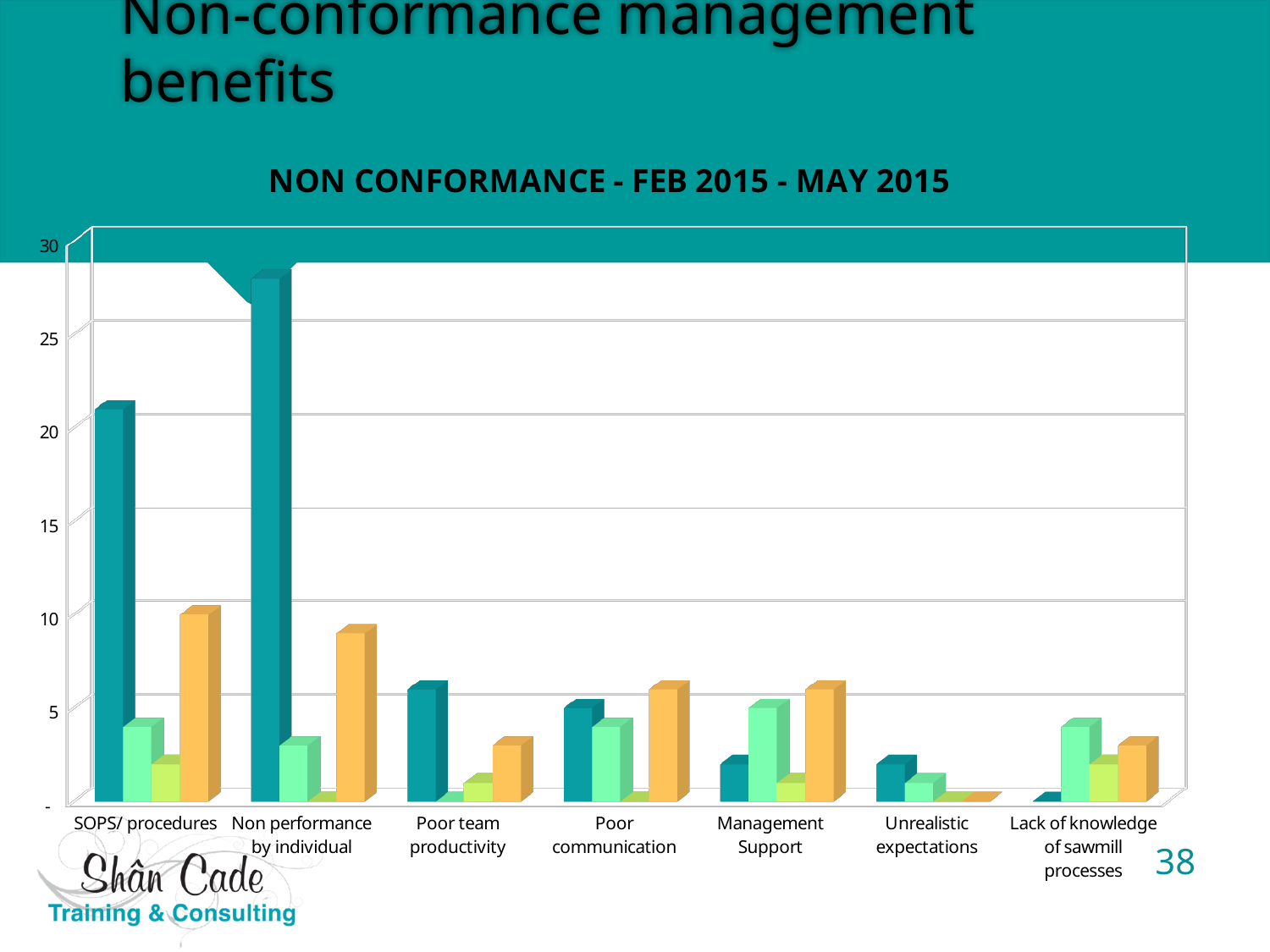
Is the dark teal bar for Poor team productivity greater or less than 10? less How many categories are shown along the x axis of the chart? 7 Is the dark teal bar for SOPS/ procedures greater or less than 15? greater Which category has the tallest bar in the chart? Non performance by individual What is the highest value shown on the vertical axis of the chart? 30 Which has the larger dark teal bar, SOPS/ procedures or Poor team productivity? SOPS/ procedures What type of chart is shown on the slide? bar chart Is the dark teal bar for Non performance by individual greater or less than 25? greater What is the title of the chart? NON CONFORMANCE - FEB 2015 - MAY 2015 Which has the larger dark teal bar, SOPS/ procedures or Non performance by individual? Non performance by individual